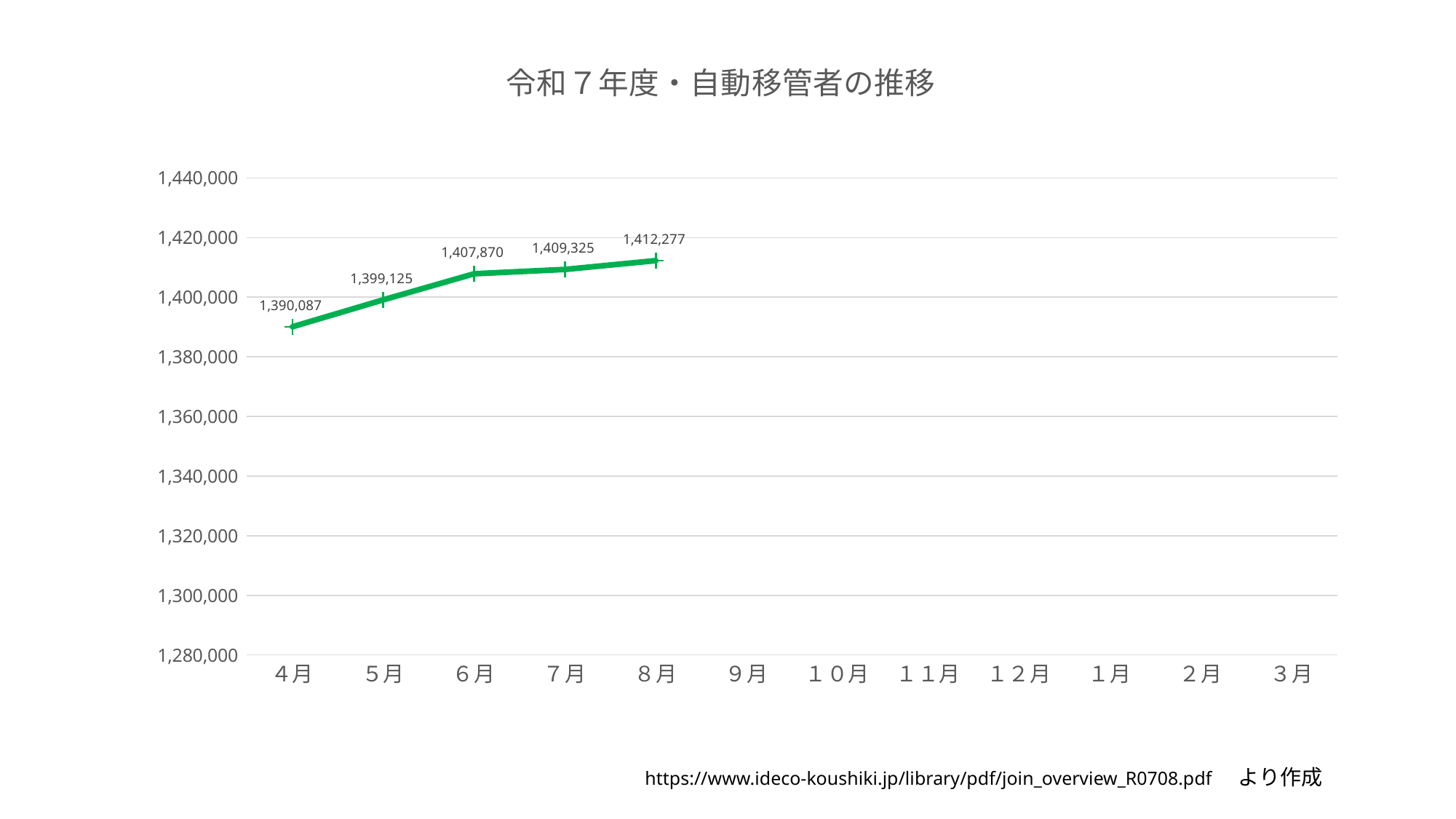
What is the difference between the values for 6月 and 5月? 8,745 Which is larger, the value for 7月 or the value for 5月? 7月 What is the value plotted for 6月? 1,407,870 What kind of chart is shown on the slide? line chart Which month has the lowest plotted value? 4月 Which month has the highest plotted value? 8月 What is the difference between the values for 8月 and 4月? 22,190 What is the value plotted for 8月? 1,412,277 Do the plotted values rise or fall from 4月 to 8月? rise What is the value plotted for 4月? 1,390,087 How many data points are plotted on the line? 5 Is the value for 4月 greater or less than 1,400,000? less